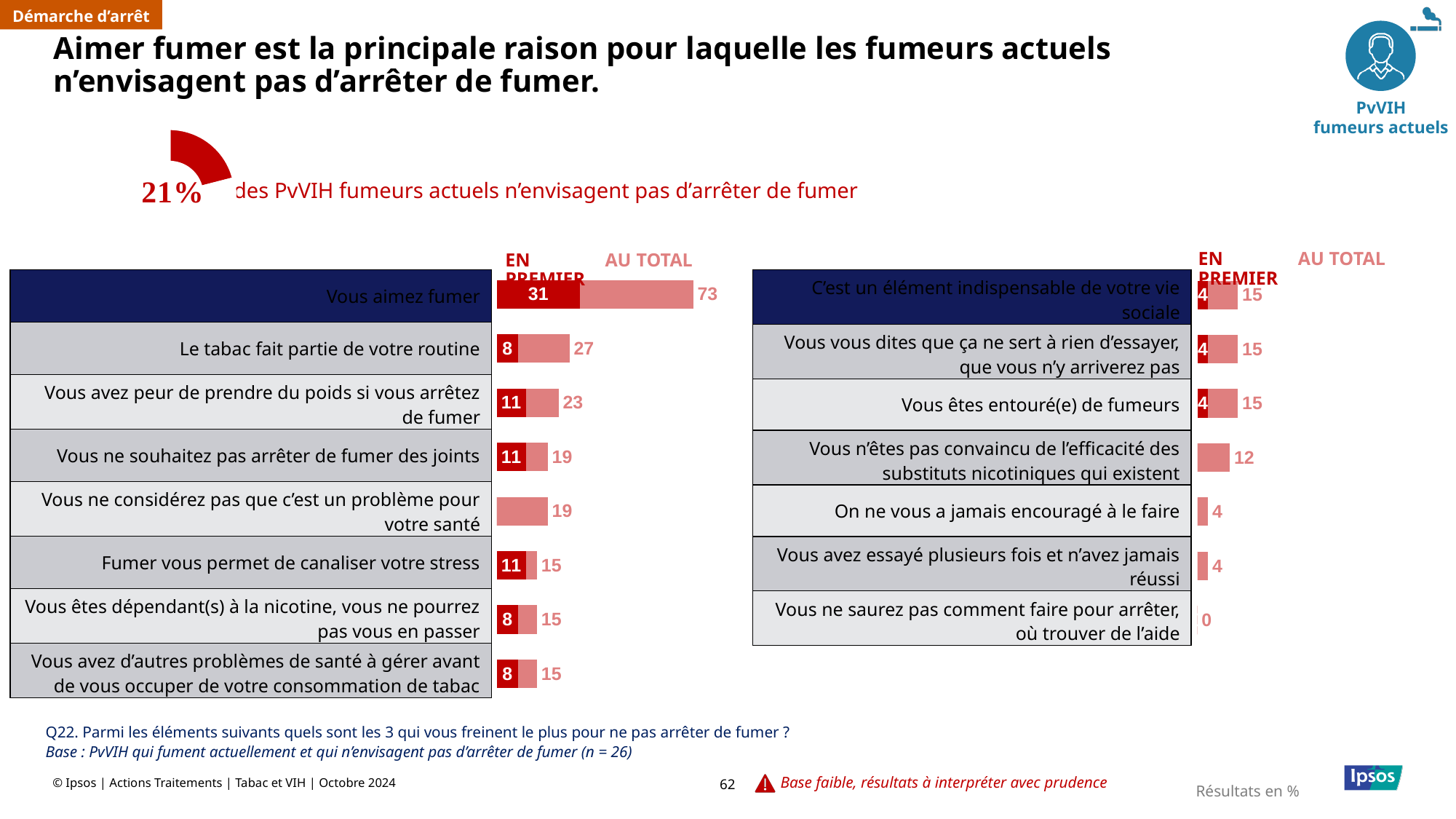
In the left chart, which category has the highest 'AU TOTAL' value? Vous aimez fumer In the left chart, what is the difference between the 'AU TOTAL' values for 'Vous aimez fumer' and 'Le tabac fait partie de votre routine'? 46 In the right chart, what is the 'AU TOTAL' value for 'Vous n'êtes pas convaincu de l'efficacité des substituts nicotiniques qui existent'? 12 In the left chart, which has a larger 'AU TOTAL' value: 'Vous avez peur de prendre du poids si vous arrêtez de fumer' or 'Fumer vous permet de canaliser votre stress'? Vous avez peur de prendre du poids si vous arrêtez de fumer In the left chart, what is the 'AU TOTAL' value for 'Le tabac fait partie de votre routine'? 27 In the right chart, which category has the lowest 'AU TOTAL' value? Vous ne saurez pas comment faire pour arrêter, où trouver de l'aide In the left chart, what is the 'EN PREMIER' value for 'Vous aimez fumer'? 31 How many categories are shown in the right chart? 7 In the left chart, what is the 'AU TOTAL' value for 'Vous aimez fumer'? 73 In the right chart, what is the 'AU TOTAL' value for 'Vous ne saurez pas comment faire pour arrêter, où trouver de l'aide'? 0 How many categories are shown in the left chart? 8 What type of chart is used on this slide? Bar chart